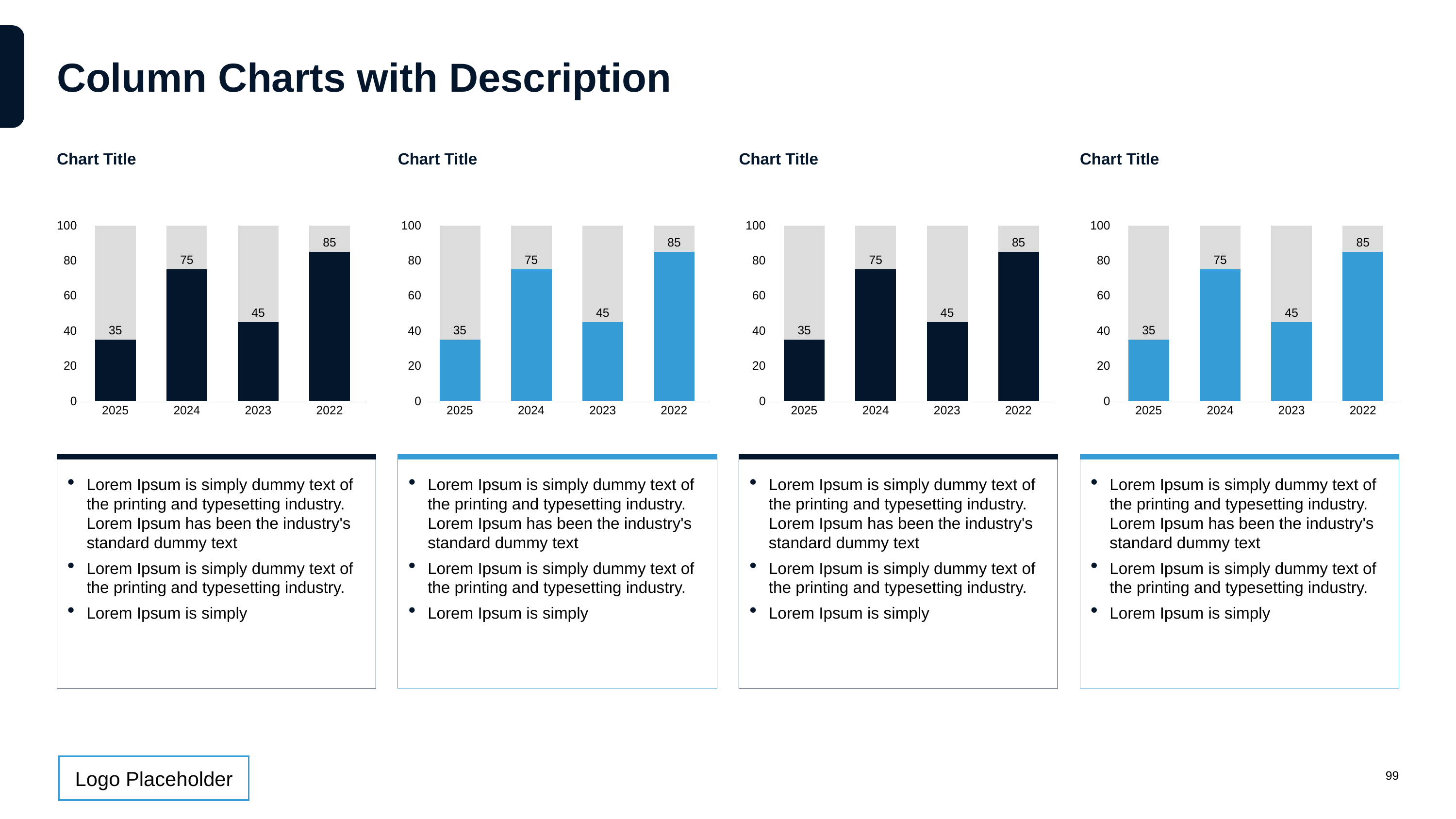
In the second chart from the left, what is the value for 2024? 75 In the rightmost chart, which year has the lowest value? 2025 In the leftmost chart, which year has the highest value? 2022 In the third chart from the left, which is larger, the value for 2024 or the value for 2023? 2024 In the third chart from the left, what is the value for 2023? 45 In the leftmost chart, is the value for 2024 greater or less than 60? greater In the second chart from the left, what is the difference between the values for 2022 and 2025? 50 In the leftmost chart, what is the value for 2025? 35 How many years are shown on the x axis of the rightmost chart? 4 In the rightmost chart, what is the value for 2022? 85 How many charts are shown on the slide? 4 What kind of chart is the second chart from the left? bar chart